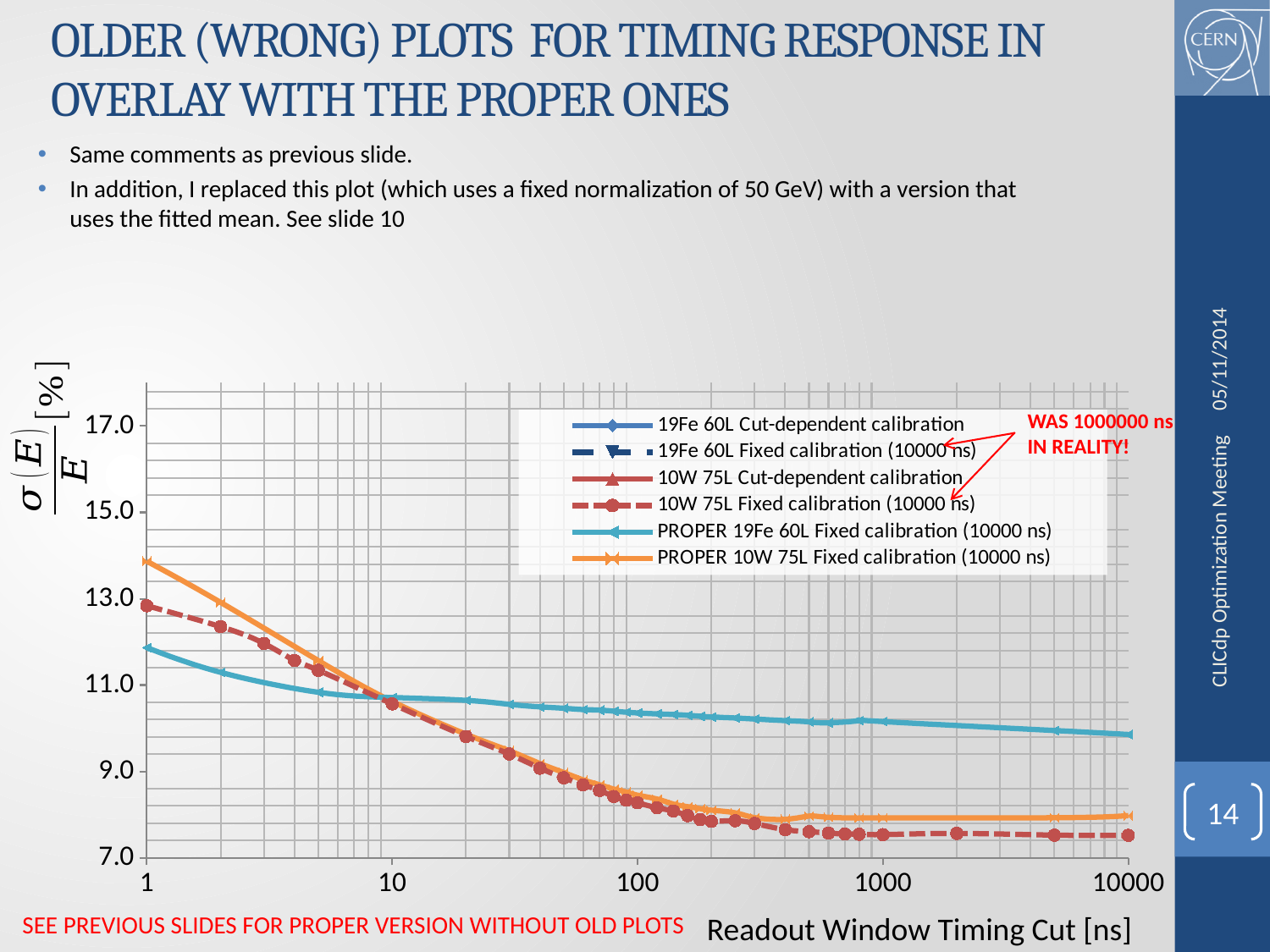
Is the value of the PROPER 10W 75L Fixed calibration (10000 ns) series at a timing cut of 1 ns greater or less than 13.0? greater At a timing cut of 1 ns, which is higher: the PROPER 10W 75L Fixed calibration (10000 ns) series or the PROPER 19Fe 60L Fixed calibration (10000 ns) series? PROPER 10W 75L Fixed calibration (10000 ns) Does the PROPER 10W 75L Fixed calibration (10000 ns) series rise or fall as the timing cut increases from 1 ns to 100 ns? fall What is the title of the x axis of the chart? Readout Window Timing Cut [ns] Which series is listed last in the chart legend? PROPER 10W 75L Fixed calibration (10000 ns) At a timing cut of 10000 ns, which is higher: the PROPER 19Fe 60L Fixed calibration (10000 ns) series or the PROPER 10W 75L Fixed calibration (10000 ns) series? PROPER 19Fe 60L Fixed calibration (10000 ns) Is the value of the PROPER 19Fe 60L Fixed calibration (10000 ns) series at a timing cut of 1 ns greater or less than 11.0? greater Is the value of the 10W 75L Fixed calibration (10000 ns) series at a timing cut of 10000 ns greater or less than 9.0? less How many series does the chart legend list? 6 What kind of chart is shown on the slide? line chart Does the PROPER 19Fe 60L Fixed calibration (10000 ns) series rise or fall as the timing cut increases along the x axis? fall